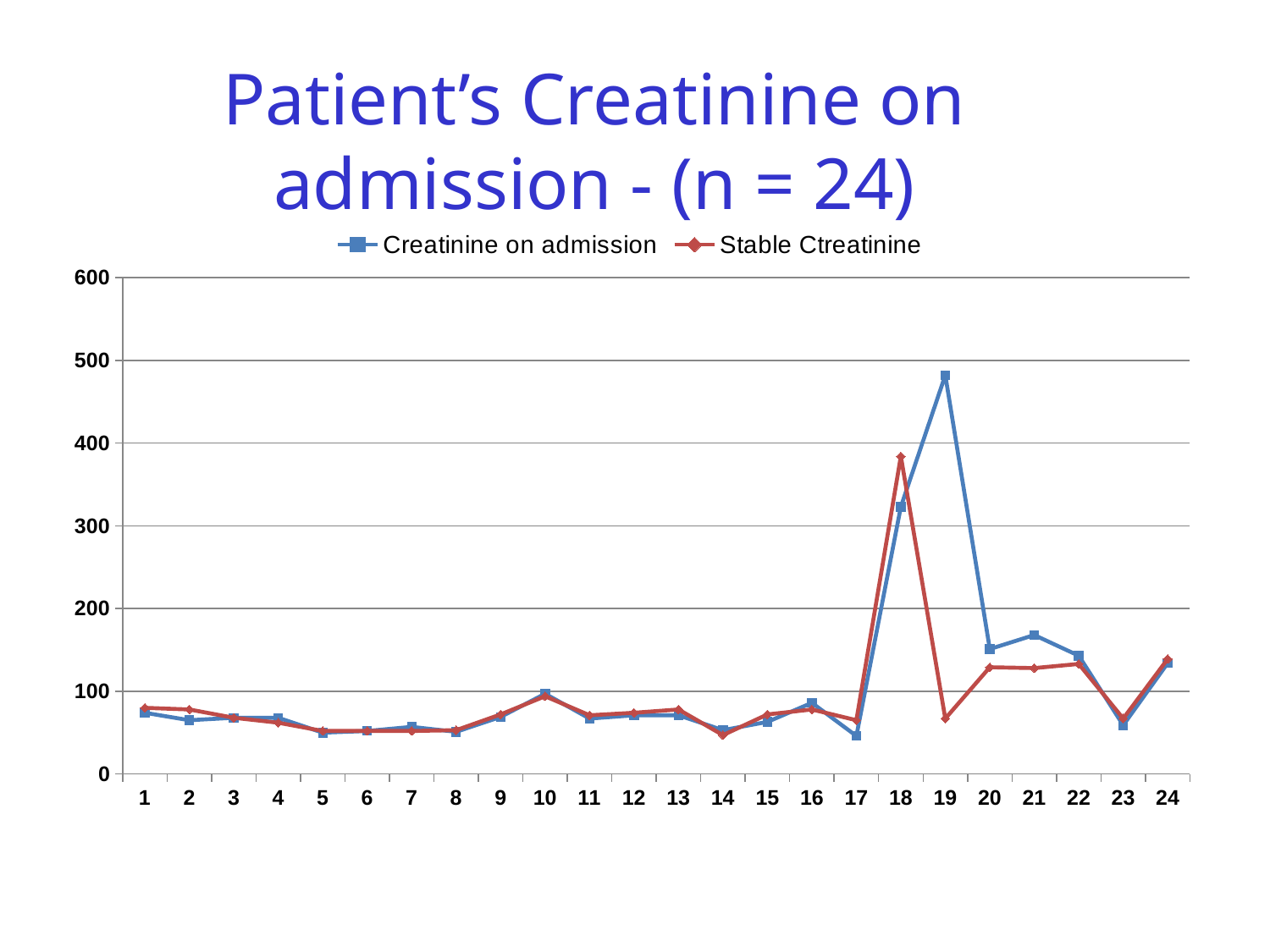
For which patient is the Stable Ctreatinine value highest? 18 Is the Stable Ctreatinine value for patient 19 greater or less than 100? less Is the Creatinine on admission value for patient 19 greater or less than 400? greater For which patient is the Creatinine on admission value highest? 19 What is the title of the chart on the slide? Patient's Creatinine on admission - (n = 24) How many patients are plotted along the x axis? 24 For patient 18, which series has the higher value, Creatinine on admission or Stable Ctreatinine? Stable Ctreatinine How many series does the legend list? 2 For patient 19, which series has the higher value, Creatinine on admission or Stable Ctreatinine? Creatinine on admission What kind of chart is shown on the slide? line chart Is the Stable Ctreatinine value for patient 18 greater or less than 300? greater